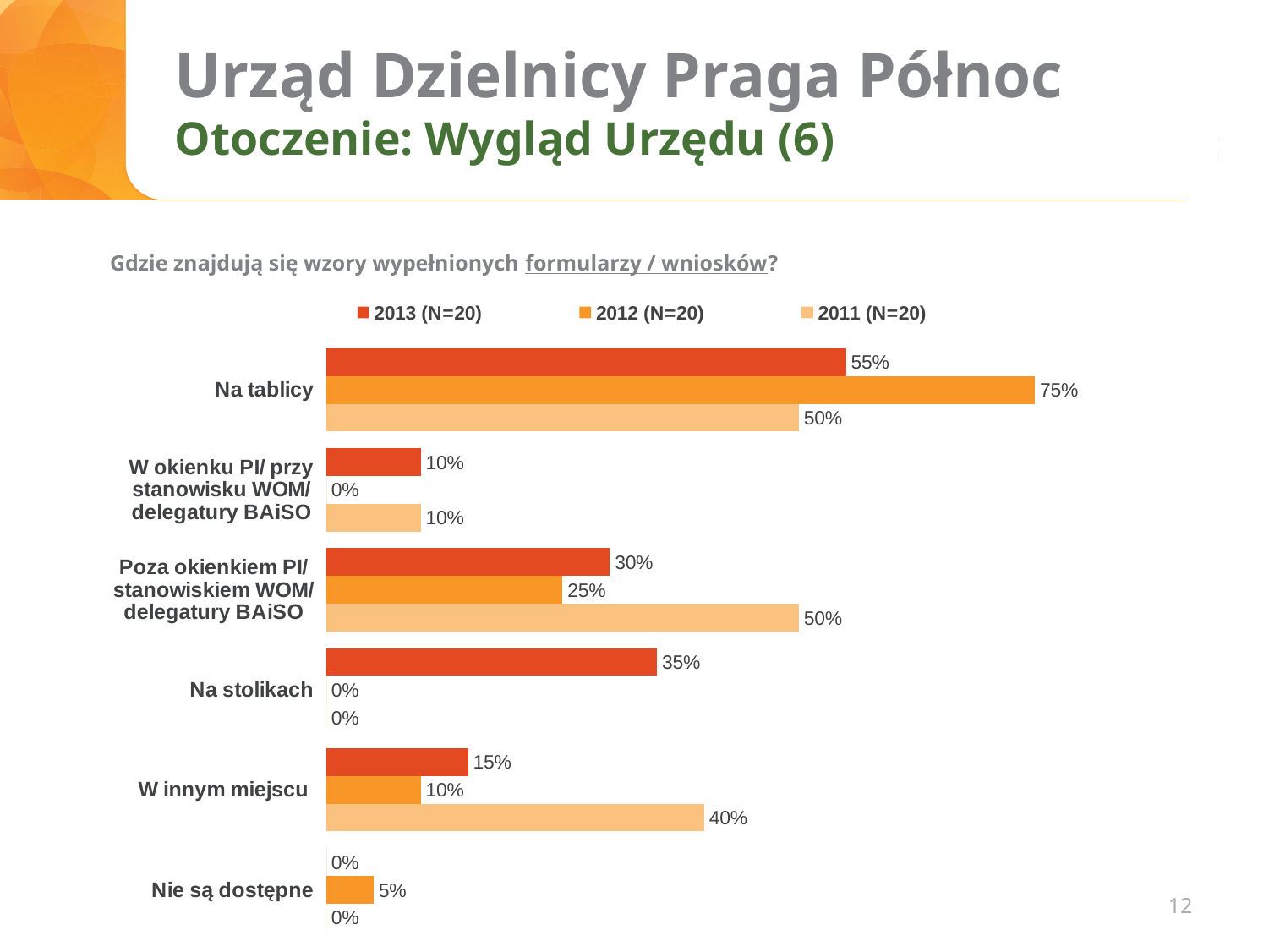
What is the value for "W innym miejscu" in the 2011 (N=20) series? 40% What is the value for "Na tablicy" in the 2012 (N=20) series? 75% What is the value for "Nie są dostępne" in the 2012 (N=20) series? 5% How many series does the legend list? 3 Which is larger for "Poza okienkiem PI/ stanowiskiem WOM/ delegatury BAiSO": the 2013 (N=20) value or the 2011 (N=20) value? 2011 (N=20) What question does the chart answer, as stated above it? Gdzie znajdują się wzory wypełnionych formularzy / wniosków? How many categories are shown on the chart? 6 Which category has the lowest value in the 2013 (N=20) series? Nie są dostępne Which category has the highest value in the 2013 (N=20) series? Na tablicy What is the value for "Na stolikach" in the 2013 (N=20) series? 35% What kind of chart is shown on the slide? Bar chart What is the difference between the 2012 (N=20) and 2011 (N=20) values for "Na tablicy"? 25%